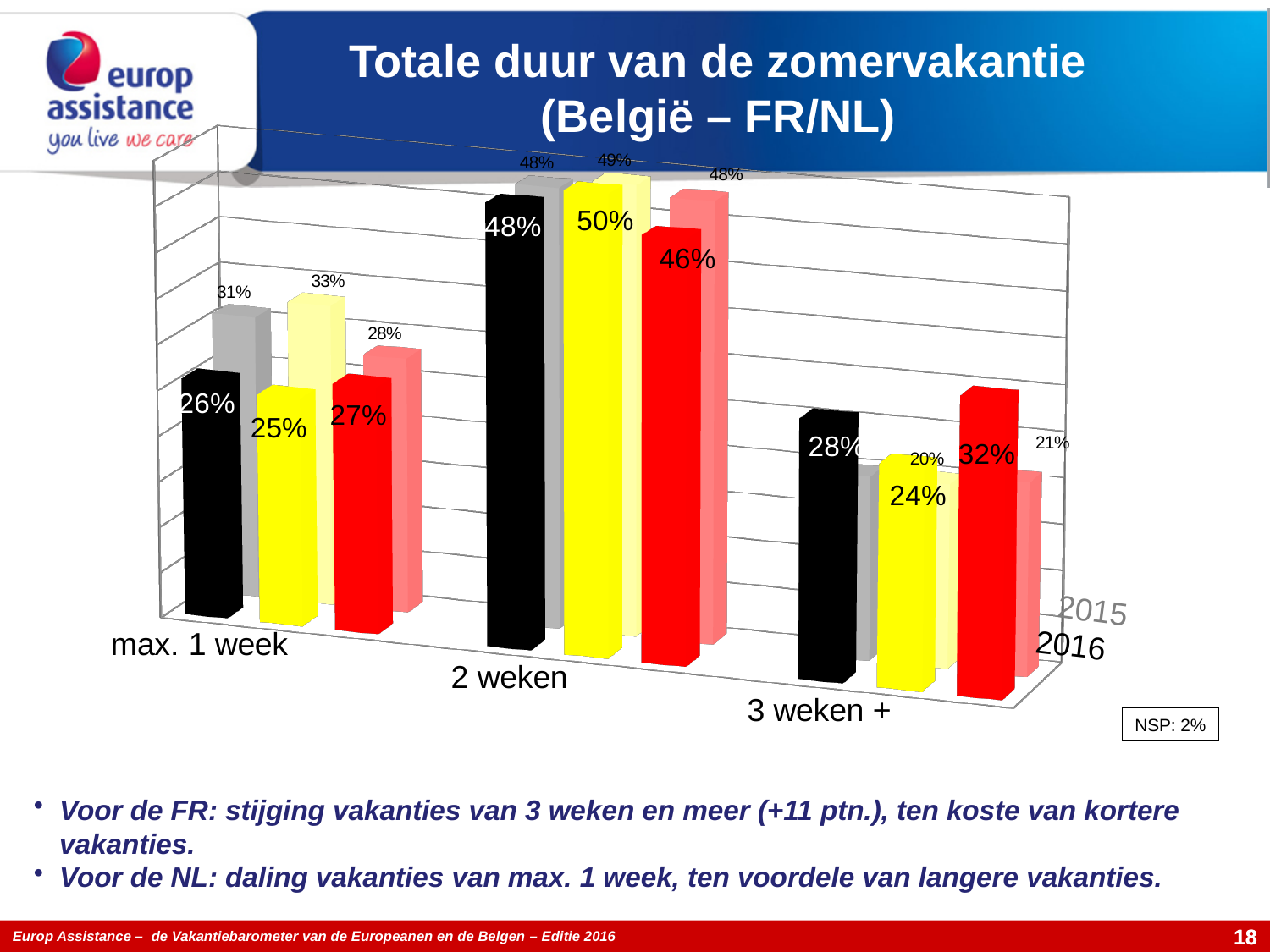
What is the value of the light yellow bar for 'max. 1 week' in 2015? 33% What is the value of the red bar for '3 weken +' in 2016? 32% What is the value of the yellow bar for '2 weken' in 2016? 50% For the yellow bars in 2016, which category has the lowest value? 3 weken + What is the difference between the red bar for '3 weken +' in 2016 (32%) and the pink bar for '3 weken +' in 2015 (21%)? 11 percentage points What is the value of the black bar for '2 weken' in 2016? 48% Which is larger for '3 weken +' in 2016: the black bar or the yellow bar? the black bar How many categories are shown on the x axis of the chart? 3 What is the value of the pink bar for '3 weken +' in 2015? 21% What kind of chart is shown on the slide? bar chart What is the title of the chart? Totale duur van de zomervakantie (België – FR/NL) For the red bars in 2016, which category has the highest value? 2 weken